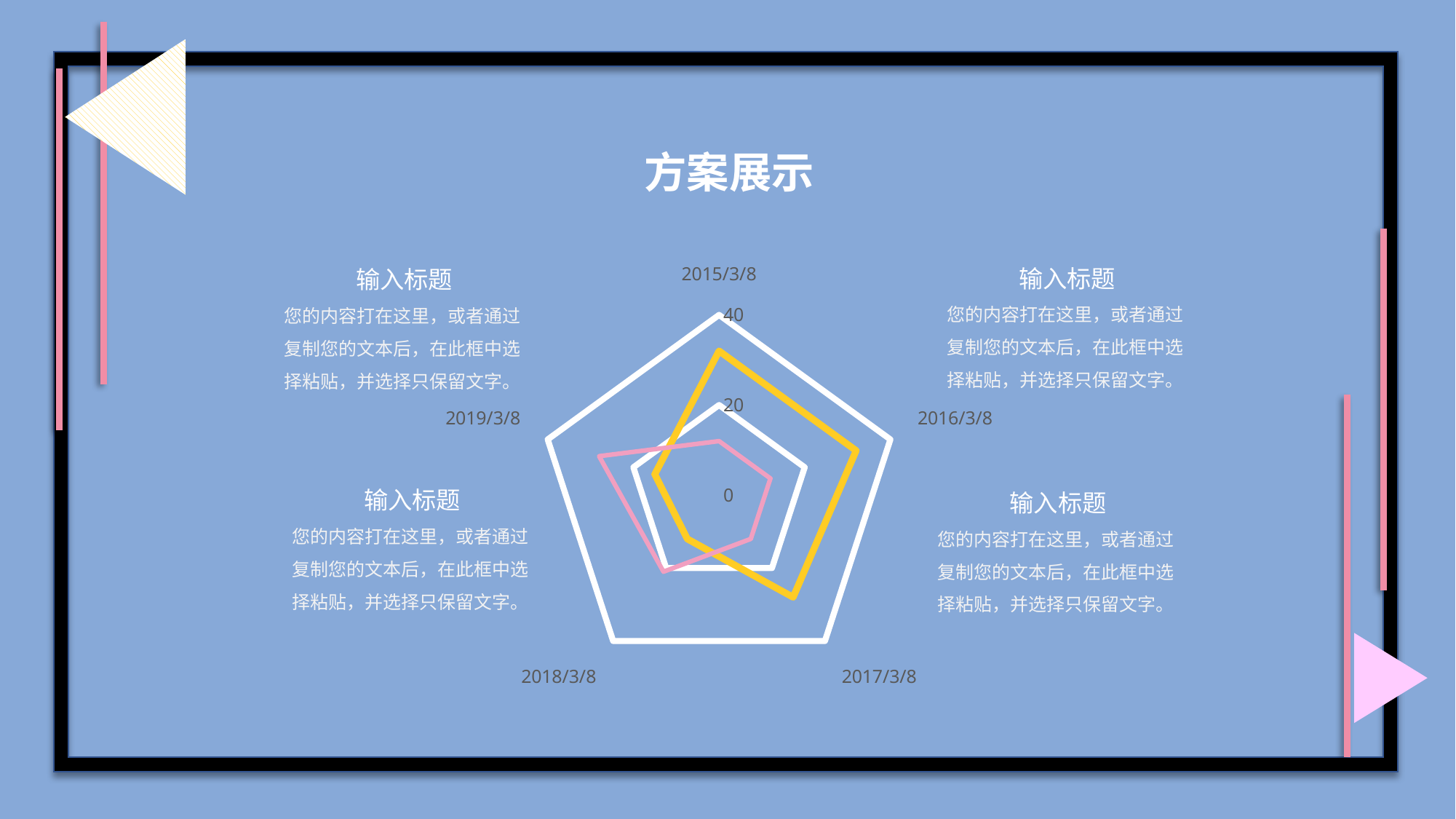
What is the title of the slide containing the radar chart? 方案展示 For 2019/3/8, which series has the larger value, the yellow or the pink? pink What is the highest value shown on the radar chart's axis scale? 40 Is the pink series value for 2015/3/8 greater or less than 20? less Is the yellow series value for 2019/3/8 greater or less than 20? less How many categories (dates) are plotted around the radar chart? 5 Is the yellow series value for 2016/3/8 greater or less than 20? greater For 2016/3/8, which series has the larger value, the yellow or the pink? yellow What kind of chart is shown on the slide? radar chart